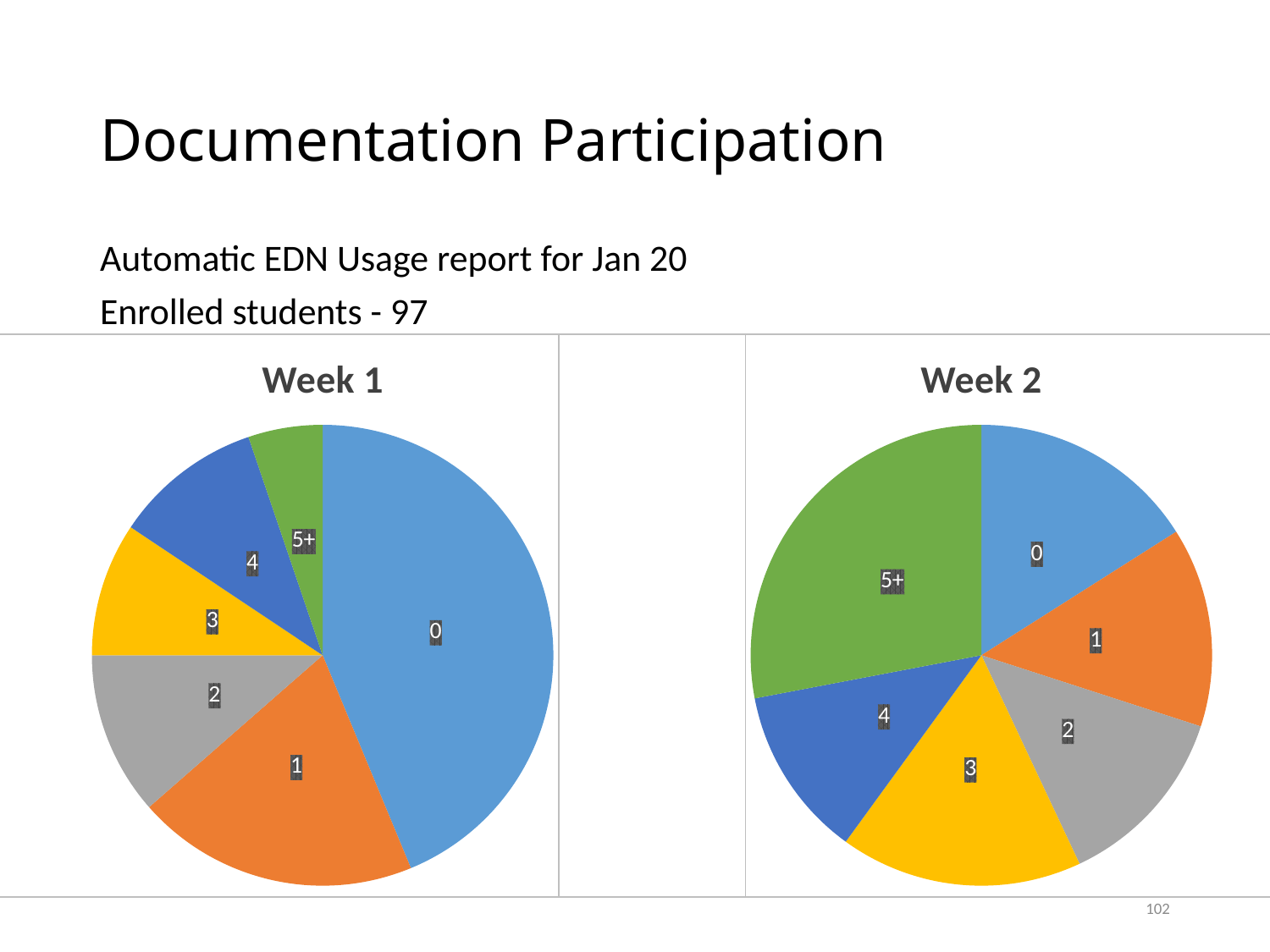
In the Week 1 chart, which category has the largest slice? 0 In the Week 2 chart, which slice is larger, 0 or 4? 0 What kind of chart is the Week 1 chart? pie chart In the Week 1 chart, which slice is larger, 1 or 5+? 1 In the Week 2 chart, which slice is larger, 5+ or 2? 5+ What kind of chart is the Week 2 chart? pie chart What is the title of the chart on the left of the slide? Week 1 In the Week 2 chart, how many slices does the pie have? 6 In the Week 1 chart, how many slices does the pie have? 6 In the Week 1 chart, which category has the smallest slice? 5+ In the Week 2 chart, what colour is the 5+ slice? green In the Week 2 chart, which category has the largest slice? 5+